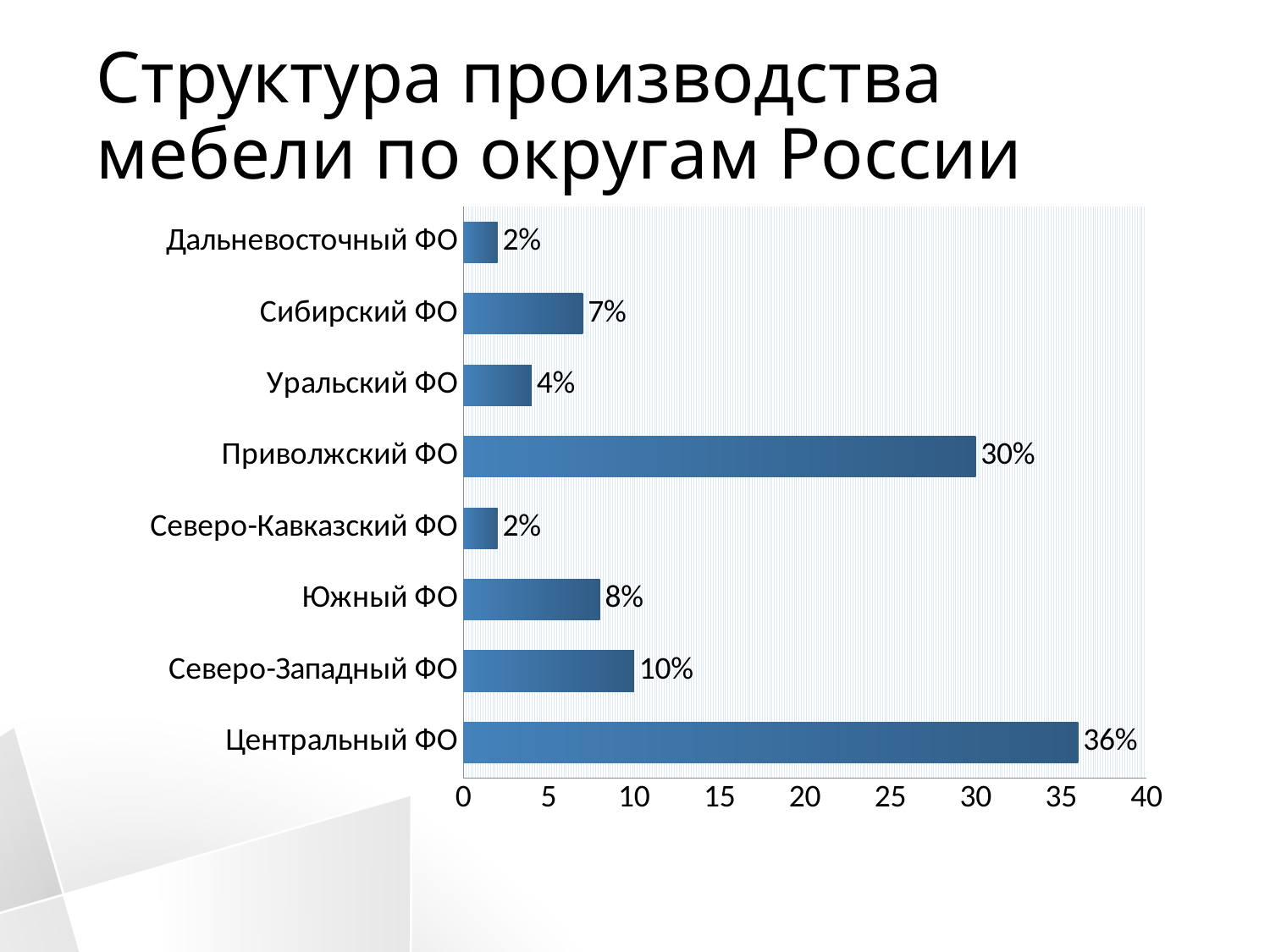
What is the difference between the values for Центральный ФО and Приволжский ФО? 6% What kind of chart is shown on the slide? Bar chart What is the value for Приволжский ФО? 30% What is the title of the slide? Структура производства мебели по округам России What is the difference between the values for Северо-Западный ФО and Южный ФО? 2% What is the value for Северо-Западный ФО? 10% Which federal district has the highest value? Центральный ФО What is the value for Сибирский ФО? 7% What is the value for Центральный ФО? 36% Which is larger, the value for Южный ФО or the value for Уральский ФО? Южный ФО Is the value for Приволжский ФО greater or less than 25? greater How many federal districts are shown in the chart? 8